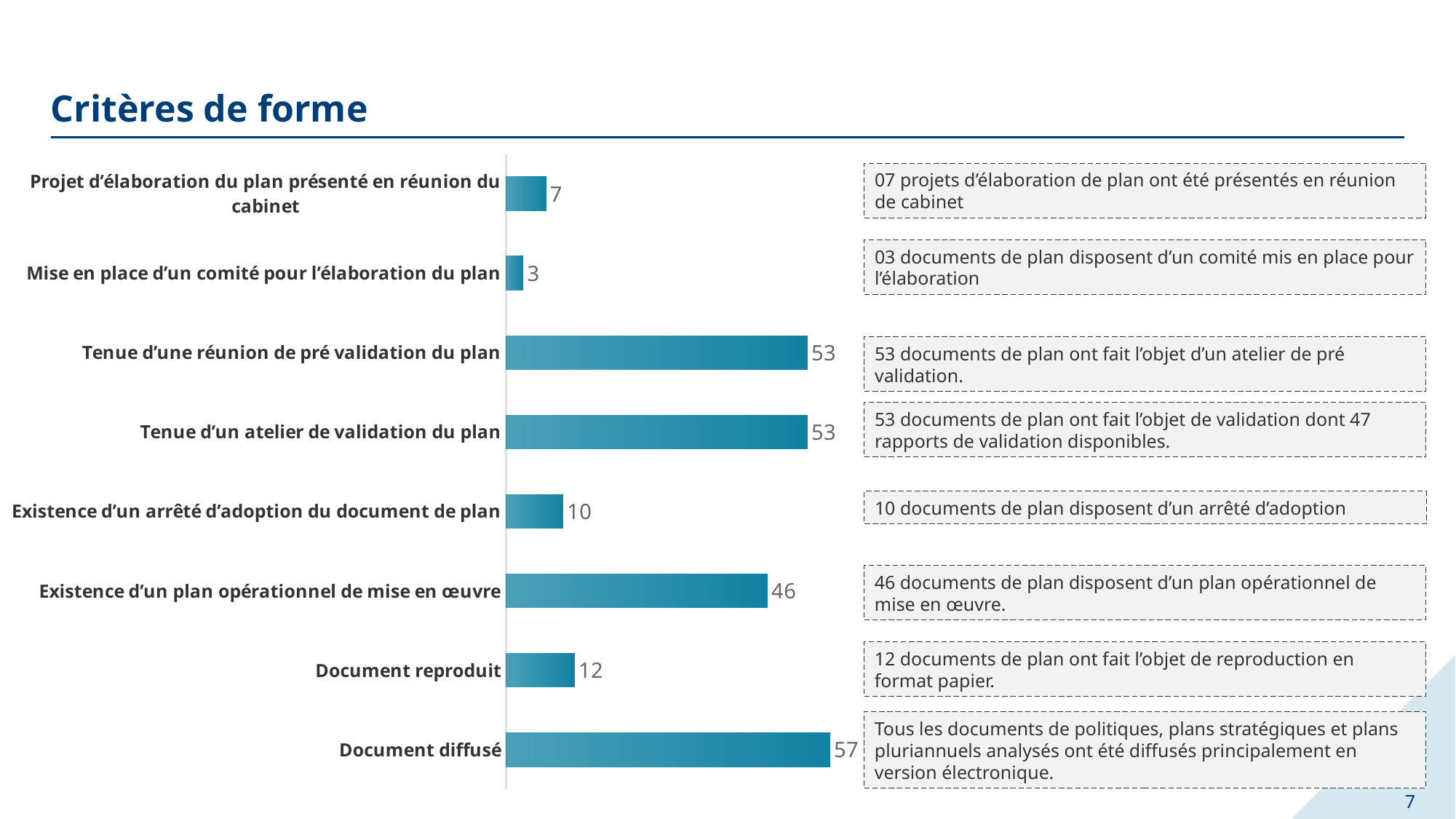
What is the difference between the values for "Document reproduit" and "Existence d'un arrêté d'adoption du document de plan"? 2 What is the value for "Document reproduit"? 12 Which category has the highest value? Document diffusé What is the value for "Mise en place d'un comité pour l'élaboration du plan"? 3 Which category has the lowest value? Mise en place d'un comité pour l'élaboration du plan What kind of chart is shown on the slide? Bar chart How many categories are shown in the chart? 8 Which is larger: the value for "Projet d'élaboration du plan présenté en réunion du cabinet" or the value for "Existence d'un arrêté d'adoption du document de plan"? Existence d'un arrêté d'adoption du document de plan What is the difference between the values for "Document diffusé" and "Existence d'un plan opérationnel de mise en œuvre"? 11 What is the title of the slide containing the chart? Critères de forme What is the value for "Document diffusé"? 57 What is the value for "Existence d'un plan opérationnel de mise en œuvre"? 46